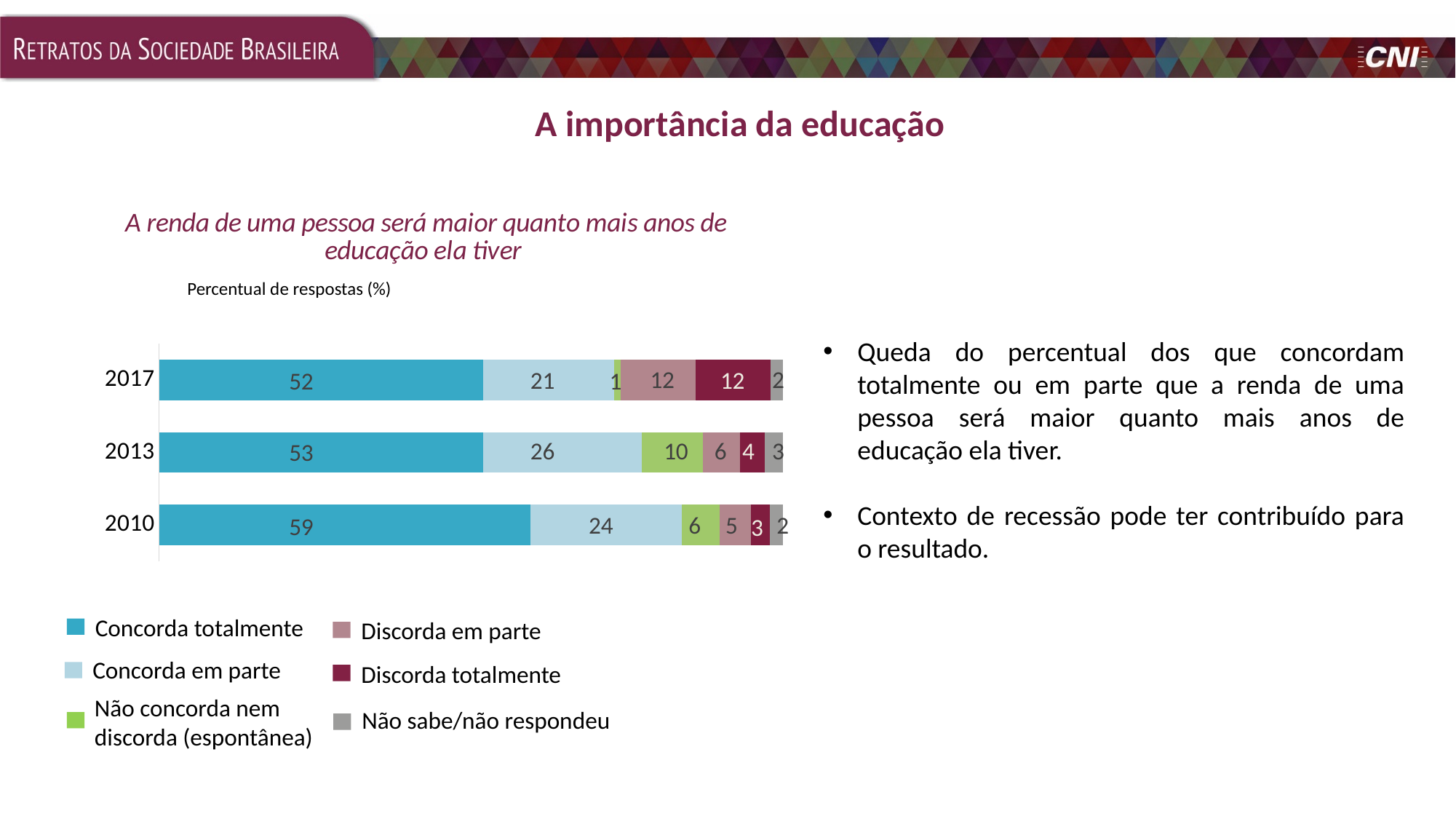
In which year is the value for "Discorda totalmente" lowest? 2010 How many years (categories) are shown on the chart? 3 What is the total of the stacked bar for 2013? 102 In which year is the value for "Concorda totalmente" highest? 2010 What is the value for "Discorda totalmente" in 2017? 12 What is the value for "Concorda totalmente" in 2017? 52 What is the difference between the "Concorda totalmente" values for 2010 and 2017? 7 What type of chart is shown on the slide? Stacked bar chart Which is larger: "Discorda em parte" in 2017 or "Discorda em parte" in 2013? 2017 How many series does the legend list? 6 What is the value for "Não concorda nem discorda (espontânea)" in 2010? 6 What is the value for "Concorda em parte" in 2013? 26